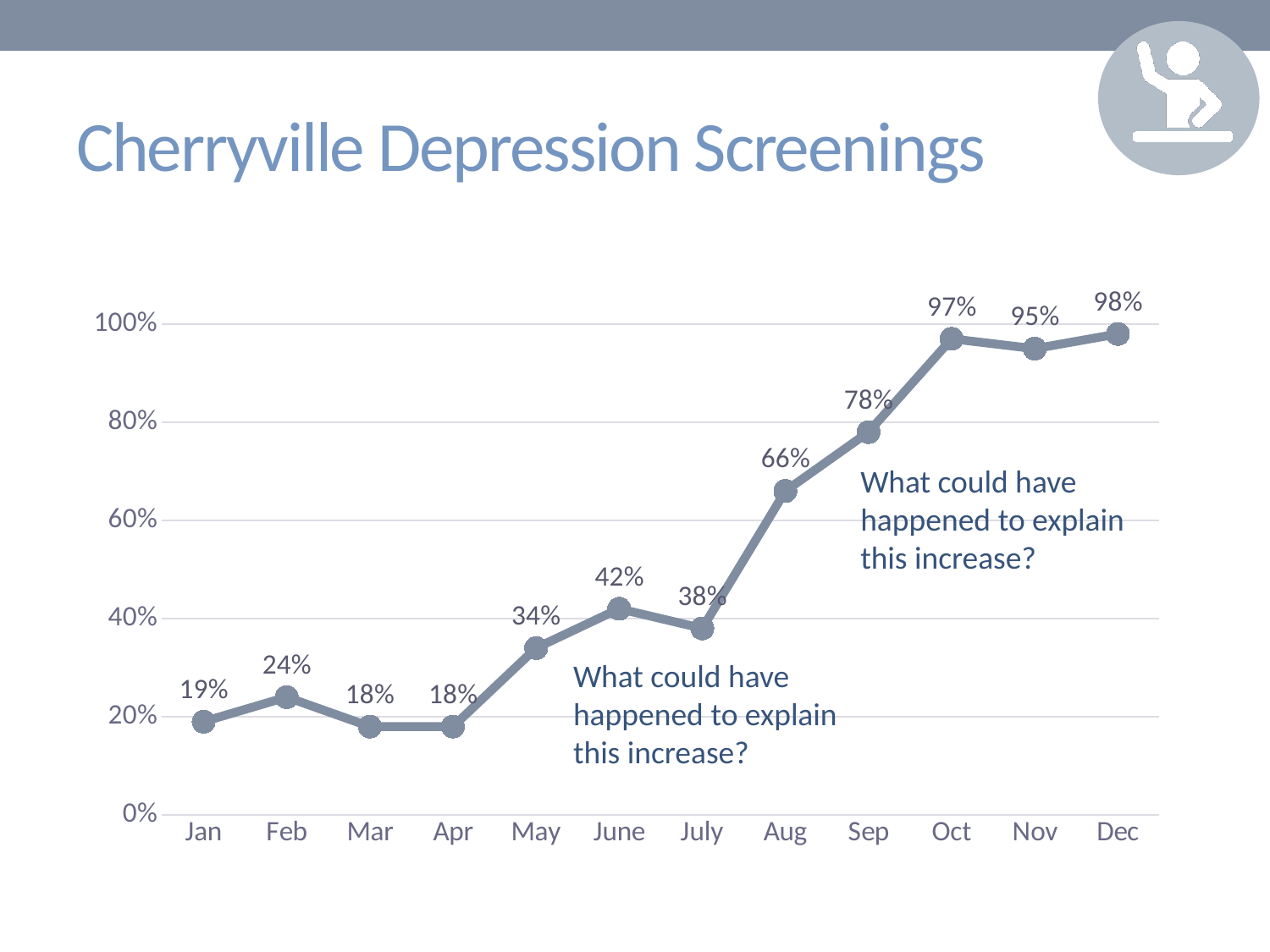
What kind of chart is shown on the slide? line chart What is the difference between the values for Dec and Jan? 79% What is the value for Aug? 66% What is the value for Sep? 78% Which month has the highest value? Dec What is the value for Jan? 19% Which is larger, the value for Feb or the value for May? May What is the difference between the values for Aug and July? 28% Do the values generally rise or fall from Jan to Dec? rise How many months are plotted on the chart? 12 Is the value for Oct greater or less than 80%? greater What is the lowest value shown on the chart? 18%